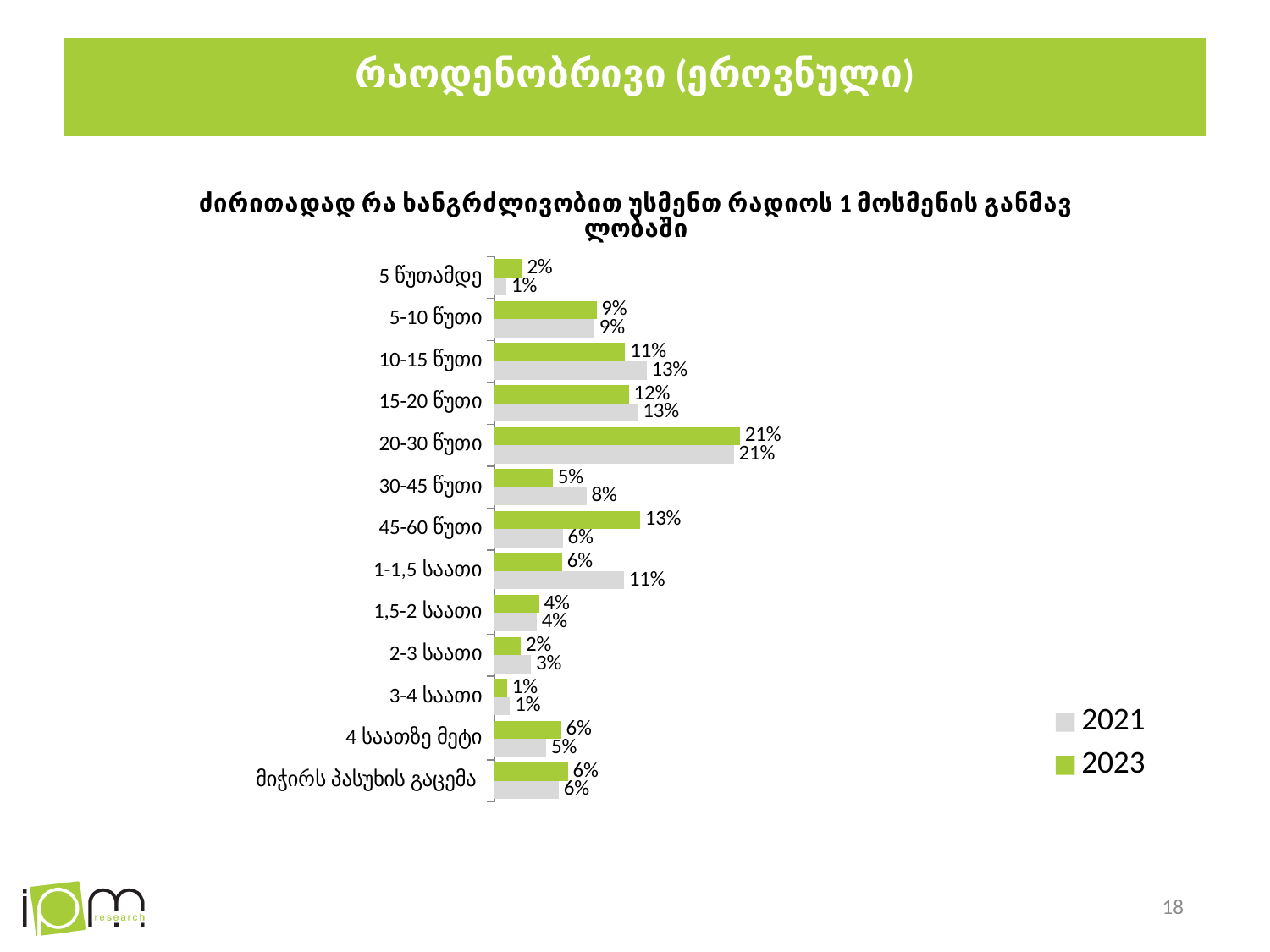
What is the 2023 value for the category "45-60 წუთი"? 13% For the category "10-15 წუთი", which year has the larger value, 2021 or 2023? 2021 What is the difference between the 2023 and 2021 values for "45-60 წუთი"? 7% What is the 2021 value for the category "30-45 წუთი"? 8% How many series does the legend list? 2 How many categories are shown on the chart? 13 What is the 2021 value for the category "1-1,5 საათი"? 11% What is the difference between the 2021 and 2023 values for "1-1,5 საათი"? 5% Which category has the lowest value in the 2023 series? 3-4 საათი Which category has the highest value in the 2023 series? 20-30 წუთი For the category "4 საათზე მეტი", which year has the larger value, 2021 or 2023? 2023 What kind of chart is shown on the slide? Bar chart